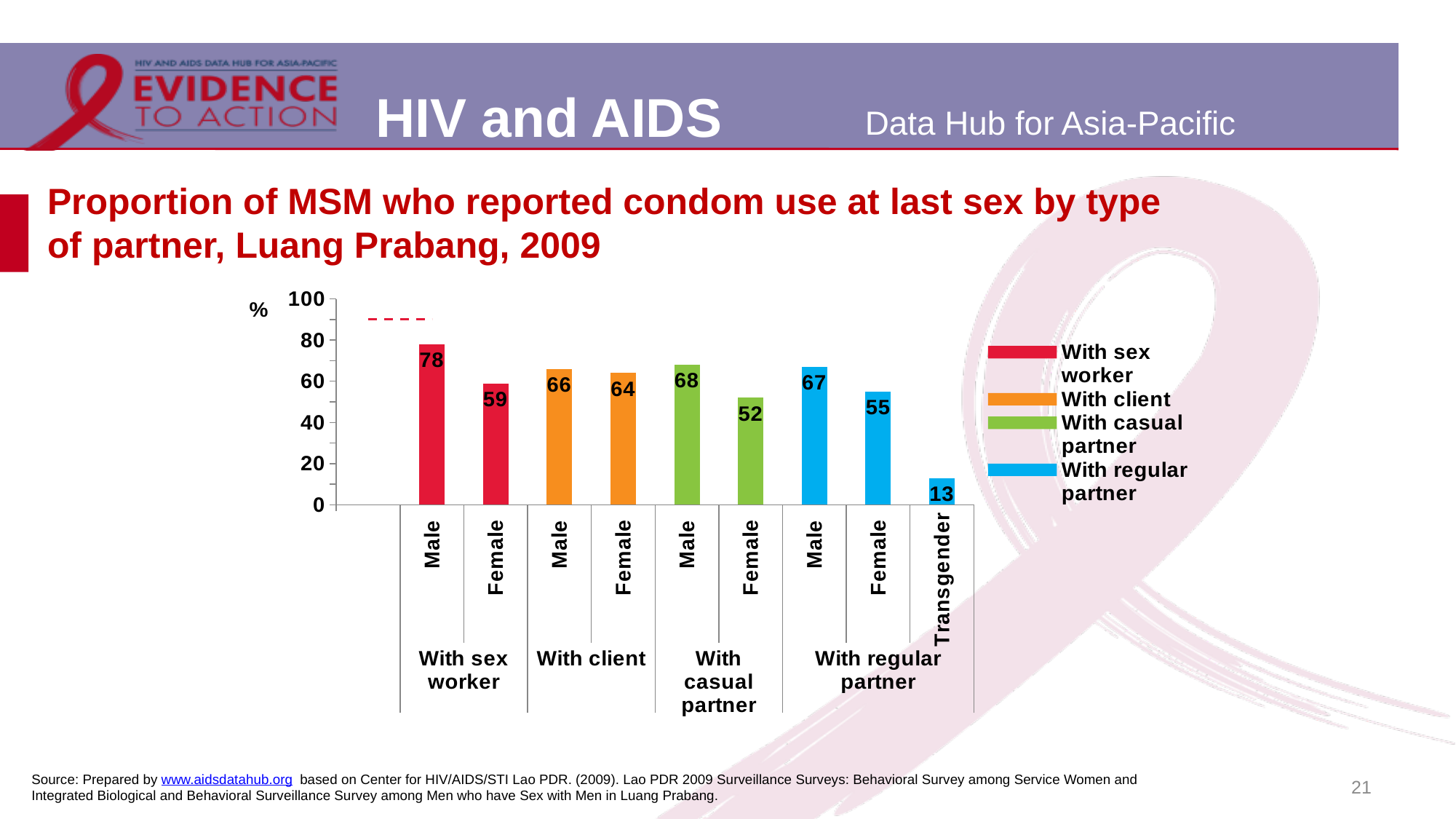
How many entries does the legend list? 4 How many bars are plotted in the chart? 9 What is the difference between Male with casual partner and Female with casual partner? 16 Is the value for Male with regular partner greater or less than 60? greater What is the difference between Male with sex worker and Female with sex worker? 19 Which bar has the highest value? Male with sex worker Which is larger, Female with client or Female with regular partner? Female with client What kind of chart is shown on the slide? Bar chart What is the value for Male with sex worker? 78 Which bar has the lowest value? Transgender with regular partner What is the value for Transgender with regular partner? 13 What is the value for Female with casual partner? 52